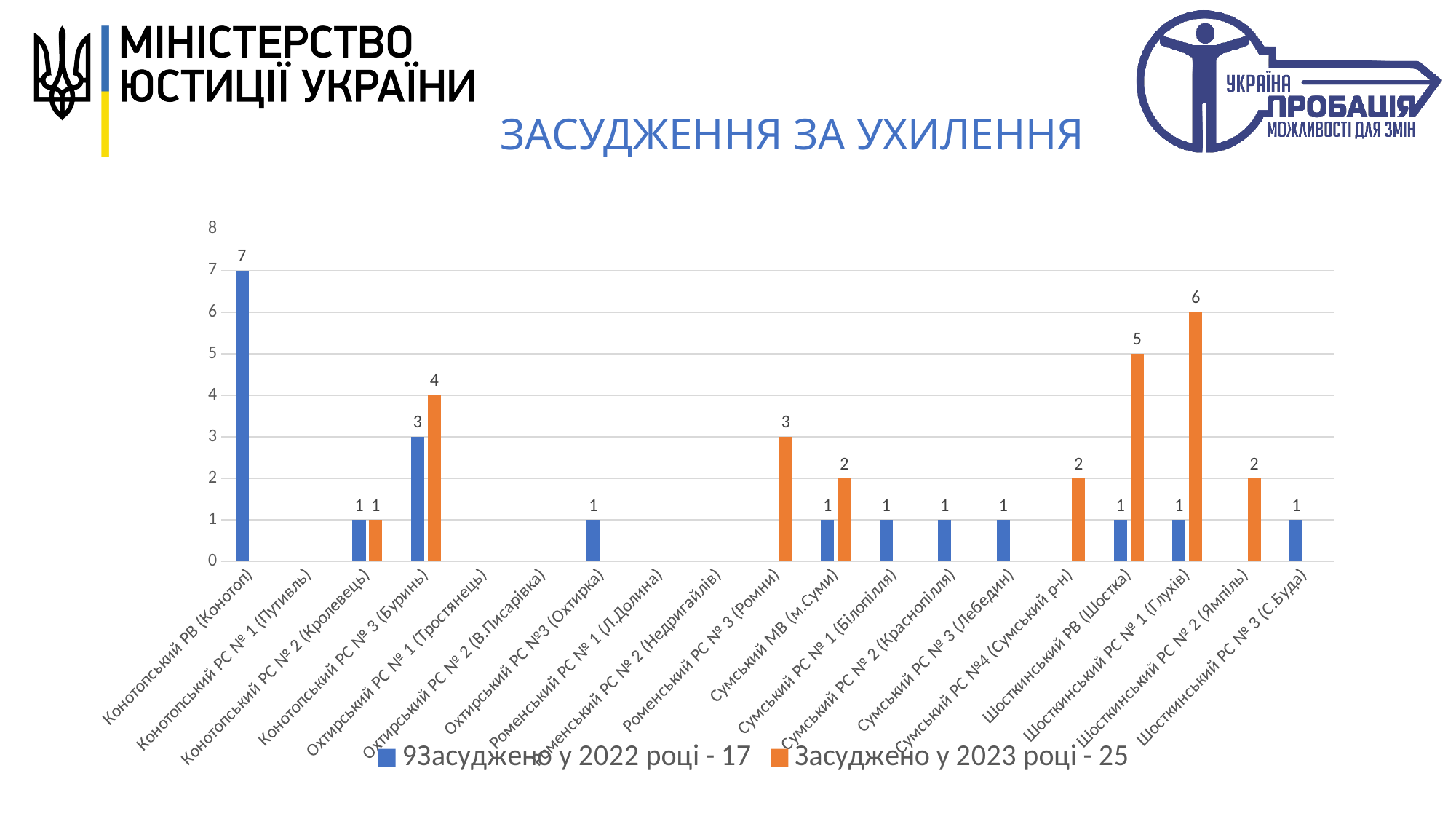
What is the difference between the 2022 values for Конотопський РВ (Конотоп) and Конотопський РС № 3 (Буринь)? 4 What is the value for Конотопський РВ (Конотоп) in the 2022 series? 7 What is the value for Роменський РС № 3 (Ромни) in the 2023 series? 3 What type of chart is shown on the slide? bar chart Which category has the highest value in the 2022 series? Конотопський РВ (Конотоп) What is the title of the chart? ЗАСУДЖЕННЯ ЗА УХИЛЕННЯ How many series does the legend list? 2 What is the difference between the 2023 and 2022 values for Шосткинський РВ (Шостка)? 4 Which is larger for Сумський МВ (м.Суми): the 2022 value or the 2023 value? 2023 What is the value for Шосткинський РС № 1 (Глухів) in the 2023 series? 6 What is the value for Конотопський РС № 3 (Буринь) in the 2023 series? 4 Which category has the highest value in the 2023 series? Шосткинський РС № 1 (Глухів)